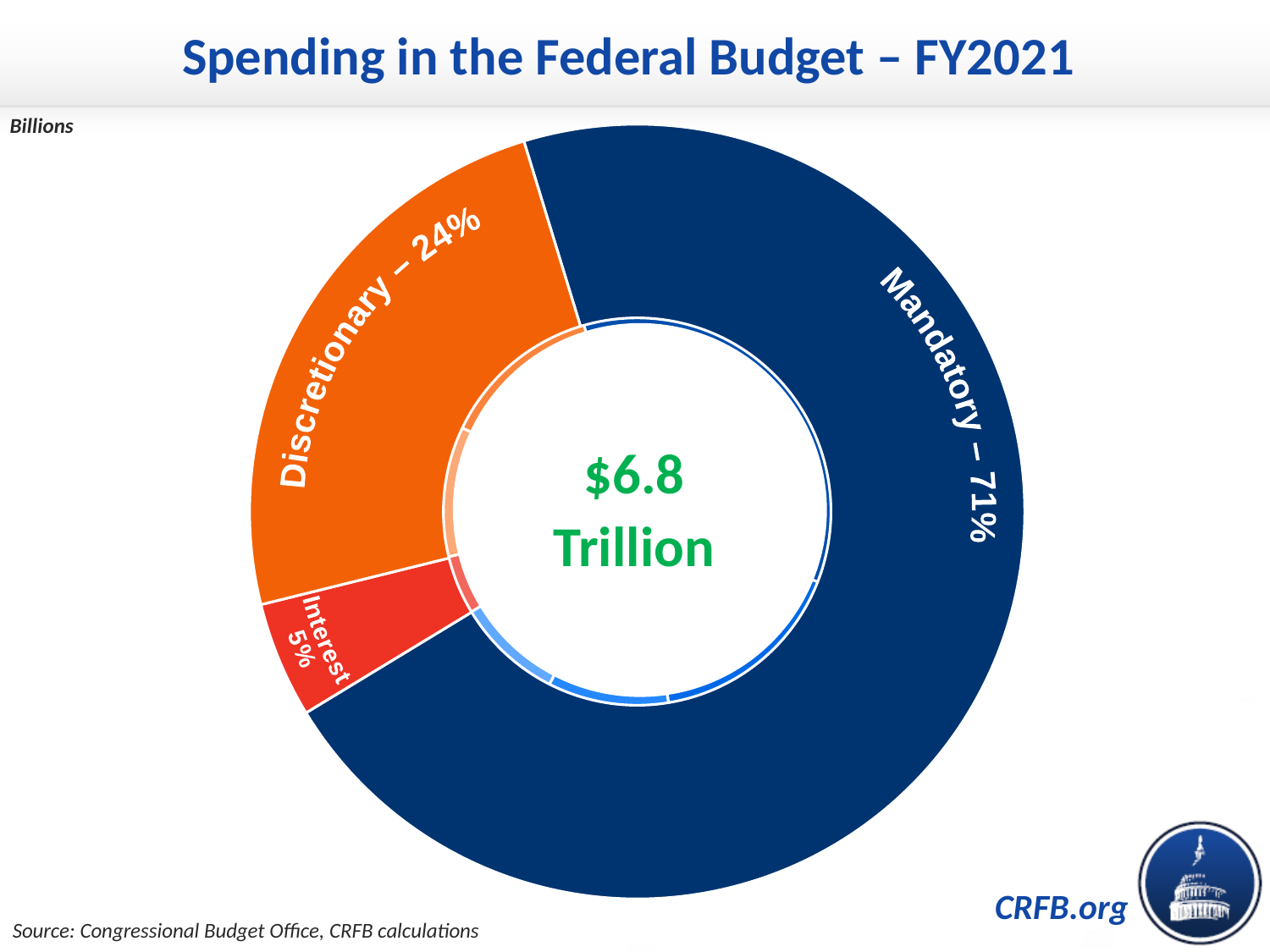
What is the difference in percentage points between the Discretionary and Interest shares? 19 What share of the federal budget spending is Mandatory? 71% What share of the federal budget spending is Interest? 5% Which category has the largest share of spending? Mandatory Which category has the smallest share of spending? Interest What total spending amount is shown in the center of the chart? $6.8 Trillion How many labeled categories does the chart show? 3 What is the difference in percentage points between the Mandatory and Discretionary shares? 47 Which is larger, the Discretionary share or the Interest share? Discretionary What is the title of the chart? Spending in the Federal Budget – FY2021 What kind of chart is shown on the slide? Pie chart (donut) What share of the federal budget spending is Discretionary? 24%